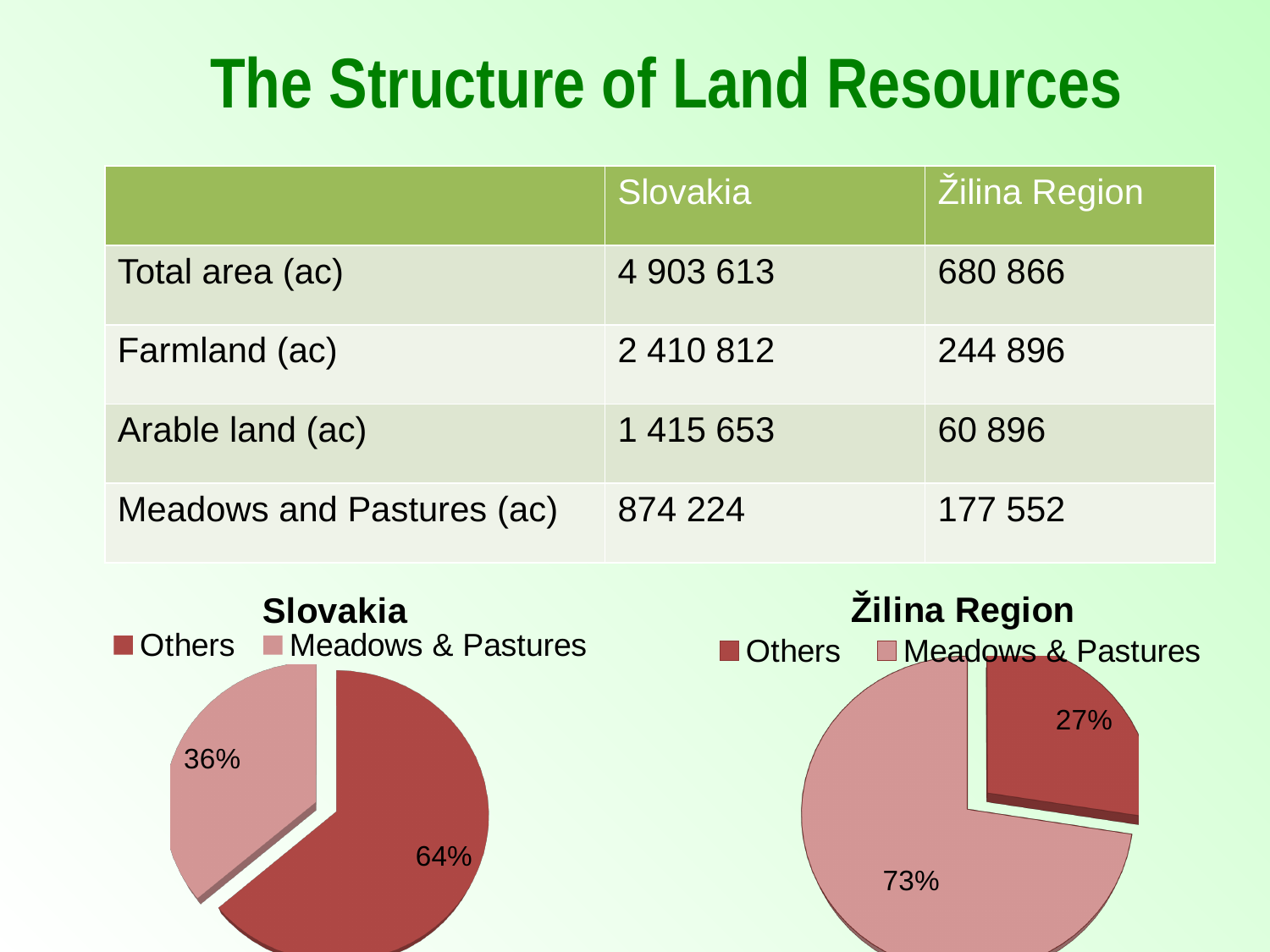
In the Slovakia pie chart, what is the difference between the Others share and the Meadows & Pastures share? 28% In the Žilina Region pie chart, which slice is the smallest? Others In the Slovakia pie chart, what share does Others have? 64% In the Žilina Region pie chart, what share does Others have? 27% How many slices does the Žilina Region pie chart have? 2 In the Slovakia pie chart, what share does Meadows & Pastures have? 36% What are the two legend entries in the Slovakia pie chart? Others and Meadows & Pastures Which is larger: the Meadows & Pastures share in the Slovakia pie chart or in the Žilina Region pie chart? Žilina Region In the Slovakia pie chart, which slice is the largest? Others In the Žilina Region pie chart, what is the difference between the Meadows & Pastures share and the Others share? 46% In the Žilina Region pie chart, what share does Meadows & Pastures have? 73% What type of chart is the Slovakia chart? Pie chart